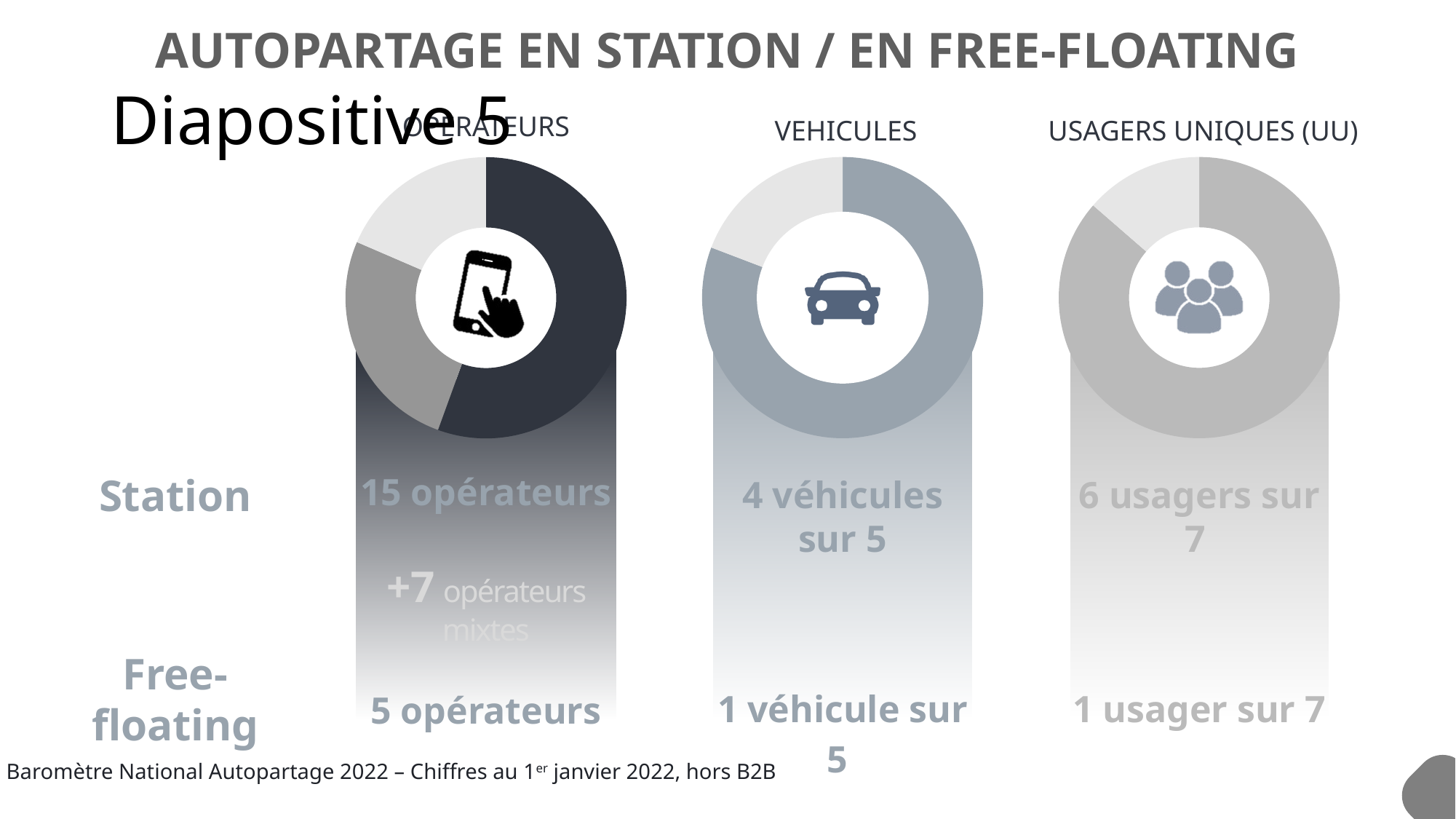
In the left chart (operators), how many additional mixed operators are indicated? +7 opérateurs mixtes How many donut charts are shown on the slide? 3 In the left chart (operators), how many more operators are there for Station than for Free-floating? 10 In the VEHICULES chart, what is the value for Free-floating? 1 véhicule sur 5 In the USAGERS UNIQUES (UU) chart, what is the value for Free-floating? 1 usager sur 7 In the VEHICULES chart, which has the larger share: Station or Free-floating? Station In the left chart (operators), how many operators are listed for Station? 15 opérateurs In the USAGERS UNIQUES (UU) chart, what is the value for Station? 6 usagers sur 7 How many segments does the left chart (operators) have? 3 In the VEHICULES chart, what is the value for Station? 4 véhicules sur 5 In the left chart (operators), how many operators are listed for Free-floating? 5 opérateurs What kind of chart is used for the VEHICULES figure? Donut (pie) chart